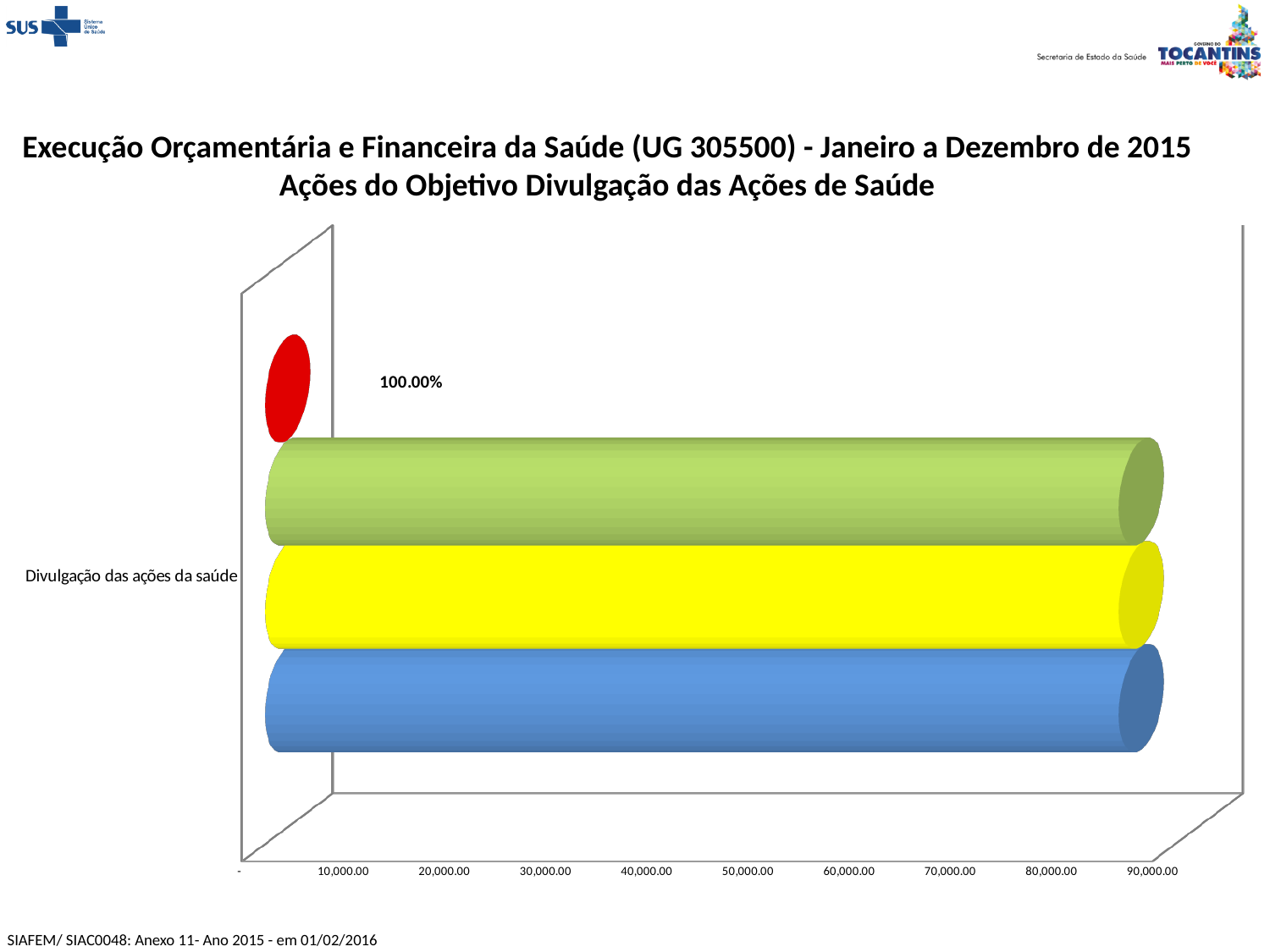
Is the value of the green bar for 'Divulgação das ações da saúde' greater or less than 80,000.00? greater What percentage value is printed as a data label on the chart? 100.00% Is the value of the blue bar for 'Divulgação das ações da saúde' greater or less than 50,000.00? greater What is the second line of the chart title on the slide? Ações do Objetivo Divulgação das Ações de Saúde How many bars are plotted for the category 'Divulgação das ações da saúde'? 3 What is the highest tick value shown on the horizontal axis of the chart? 90,000.00 Is the value of the yellow bar for 'Divulgação das ações da saúde' greater or less than 70,000.00? greater What kind of chart is shown on the slide? bar chart What is the name of the category shown on the vertical axis? Divulgação das ações da saúde How many categories are shown on the vertical axis of the chart? 1